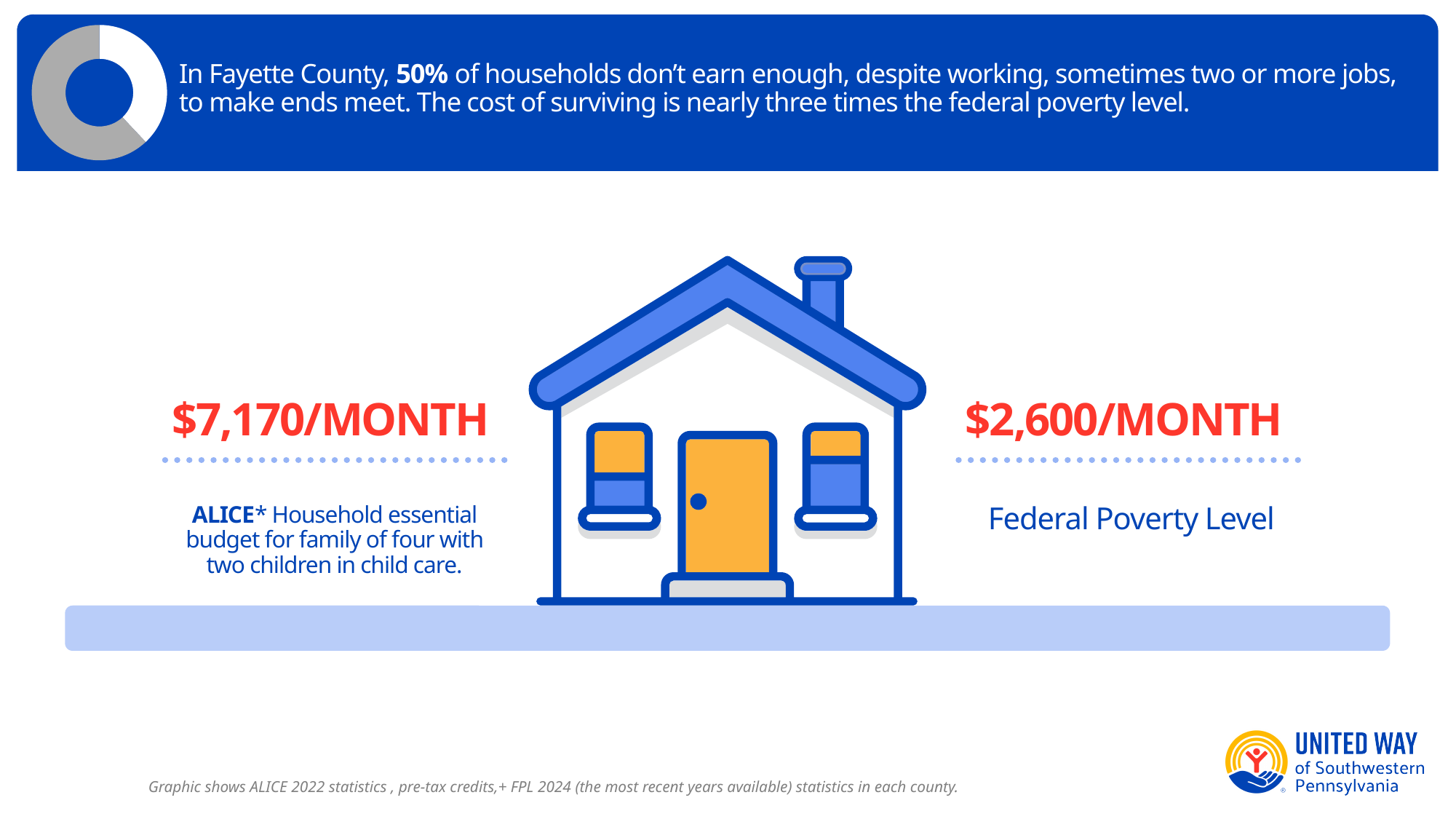
What is the difference between the ALICE household essential budget and the Federal Poverty Level per month? $4,570 How many slices does the donut chart in the top-left corner have? 2 Is the ALICE household essential budget greater or less than $5,000 per month? greater What is the ALICE household essential budget per month for a family of four with two children in child care? $7,170/MONTH What kind of chart is shown in the top-left corner of the slide? Donut chart Which is larger, the ALICE household essential budget or the Federal Poverty Level? ALICE household essential budget According to the slide, what share of households in Fayette County don't earn enough to make ends meet? 50% What is the Federal Poverty Level per month shown on the slide? $2,600/MONTH Which of the two monthly figures on the slide is the lowest? Federal Poverty Level ($2,600/MONTH) Is the Federal Poverty Level greater or less than $3,000 per month? less Which county does the slide's statistic refer to? Fayette County